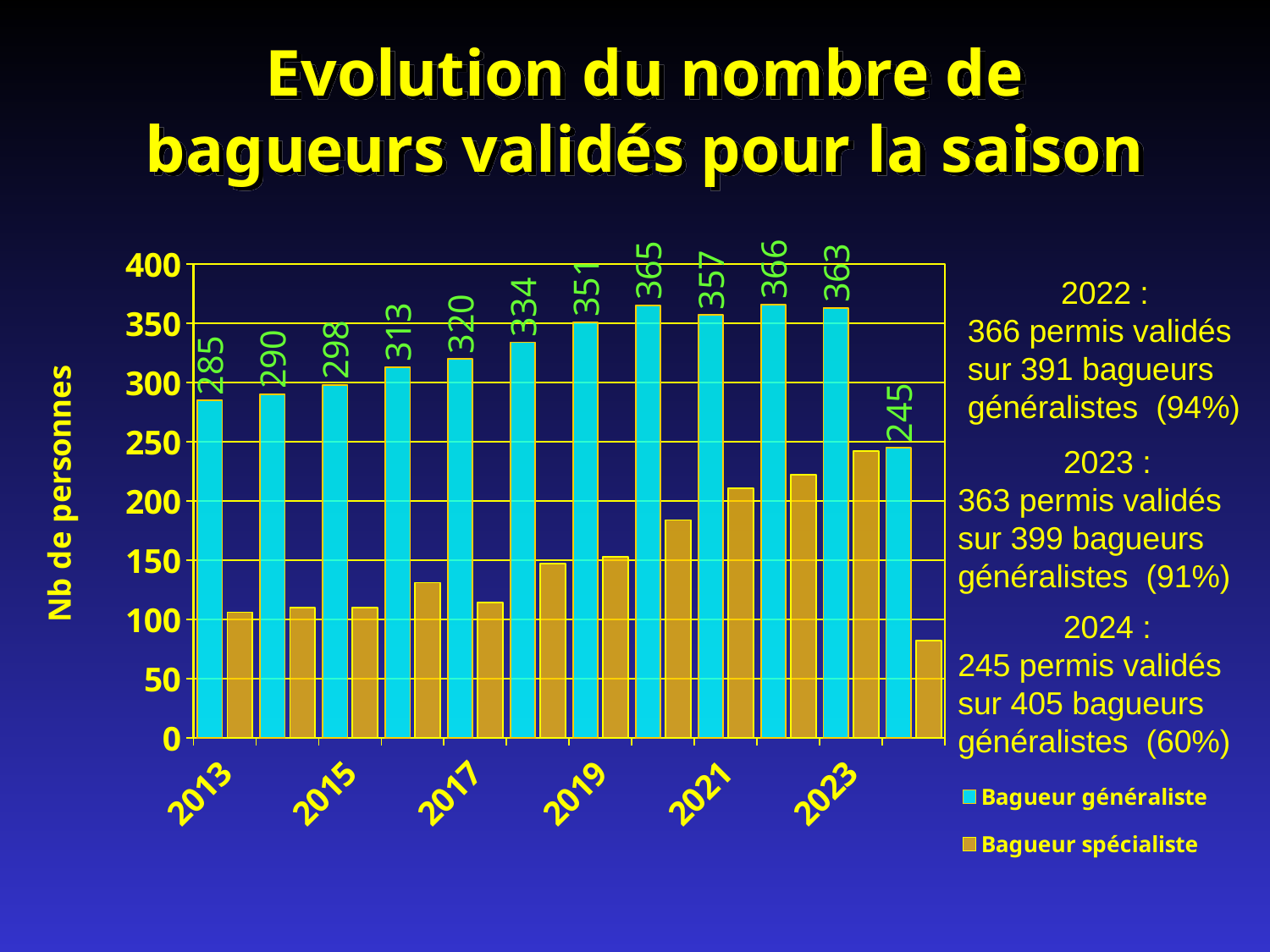
Is the value for Bagueur spécialiste in 2023 greater or less than 200? greater What is the difference between the Bagueur généraliste values for 2023 and 2024? 118 Which year has the lowest value for Bagueur généraliste? 2024 What is the value for Bagueur généraliste in 2024? 245 Does the Bagueur généraliste value rise or fall from 2013 to 2020? rise Which is larger, the Bagueur généraliste value for 2019 or for 2021? 2021 How many years are shown on the chart? 12 What kind of chart is shown on the slide? bar chart Is the value for Bagueur spécialiste in 2024 greater or less than 100? less What is the value for Bagueur généraliste in 2013? 285 What is the value for Bagueur généraliste in 2022? 366 How many series does the legend list? 2